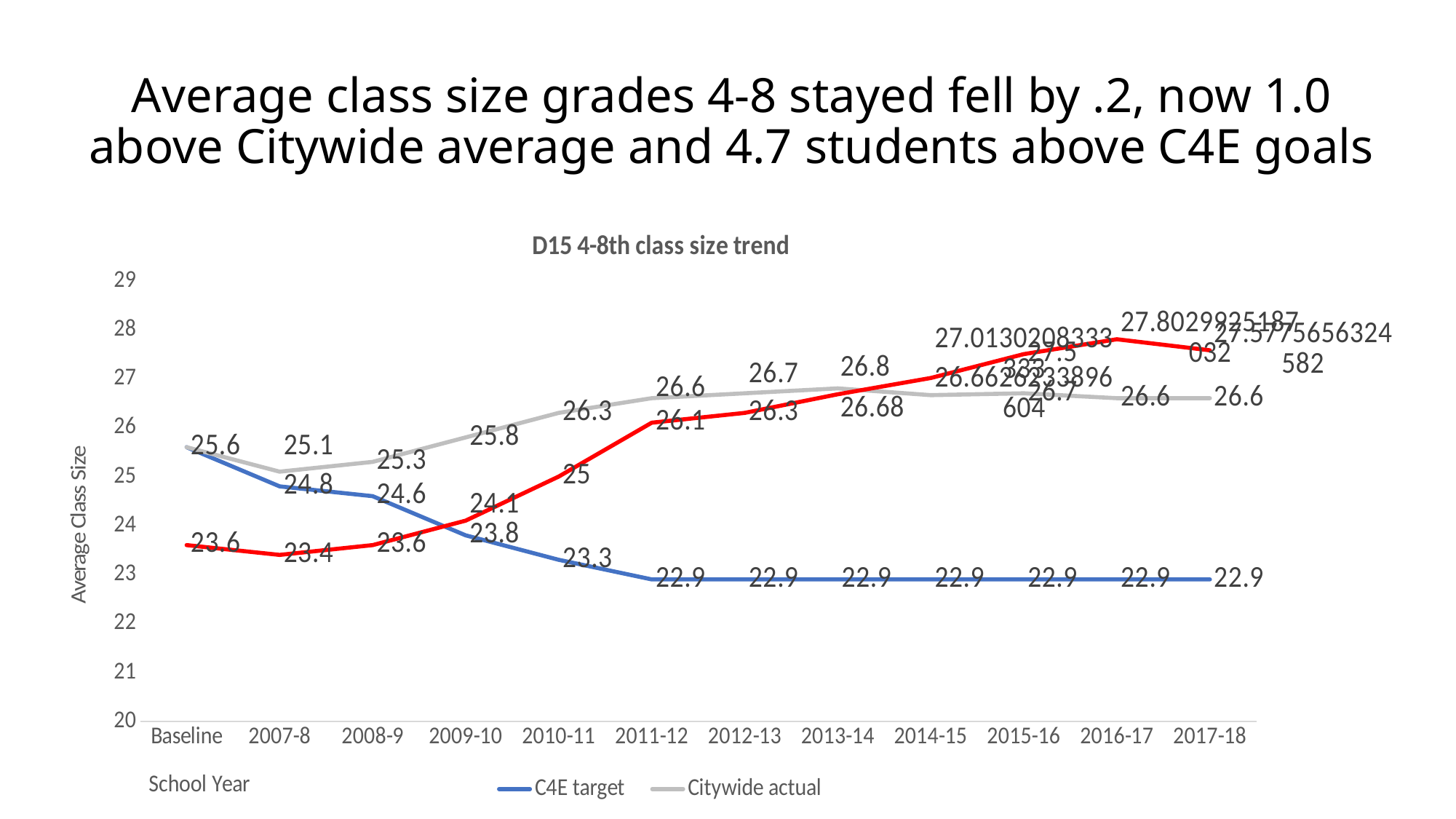
How many series does the chart legend list? 2 What is the C4E target value for 2010-11? 23.3 What is the C4E target value for 2017-18? 22.9 In which school year is the Citywide actual value lowest? 2007-8 What is the Citywide actual value for 2009-10? 25.8 In 2008-9, which is larger: the C4E target or the Citywide actual? Citywide actual Does the C4E target line rise or fall from Baseline to 2011-12? fall What is the difference between the Citywide actual and the C4E target in 2013-14? 3.9 What is the title of the chart? D15 4-8th class size trend What is the Citywide actual value for 2013-14? 26.8 How many school years are shown on the x axis, including Baseline? 12 What kind of chart is shown on the slide? line chart